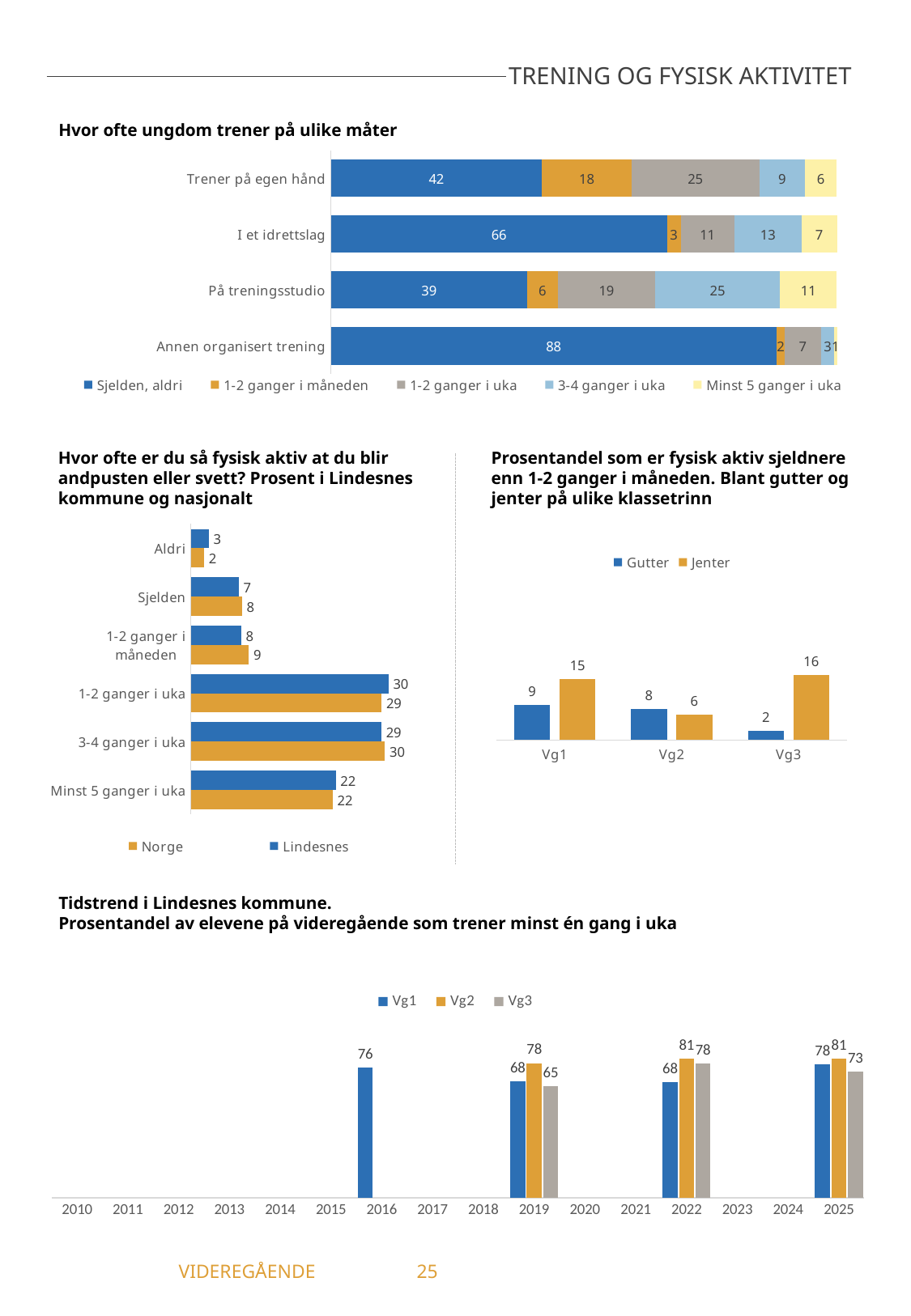
In the chart 'Prosentandel som er fysisk aktiv sjeldnere enn 1-2 ganger i måneden', which class level has the lowest value for Gutter? Vg3 In the chart 'Hvor ofte ungdom trener på ulike måter', what is the value for 'Sjelden, aldri' for 'I et idrettslag'? 66 In the chart 'Hvor ofte er du så fysisk aktiv at du blir andpusten eller svett?', which is larger for 'Sjelden': Norge or Lindesnes? Norge In the chart 'Hvor ofte er du så fysisk aktiv at du blir andpusten eller svett?', what is the value for Lindesnes for '1-2 ganger i uka'? 30 What kind of chart is 'Tidstrend i Lindesnes kommune'? Bar chart In the chart 'Tidstrend i Lindesnes kommune', what is the value for Vg2 in 2022? 81 In the chart 'Prosentandel som er fysisk aktiv sjeldnere enn 1-2 ganger i måneden', what is the difference between Jenter and Gutter at Vg1? 6 In the chart 'Hvor ofte er du så fysisk aktiv at du blir andpusten eller svett?', how many categories are shown? 6 In the chart 'Hvor ofte ungdom trener på ulike måter', what is the total of the stacked bar for 'Trener på egen hånd'? 100 In the chart 'Prosentandel som er fysisk aktiv sjeldnere enn 1-2 ganger i måneden', what is the value for Jenter at Vg3? 16 In the chart 'Hvor ofte ungdom trener på ulike måter', how many series does the legend list? 5 In the chart 'Hvor ofte ungdom trener på ulike måter', which category has the highest value for 'Sjelden, aldri'? Annen organisert trening